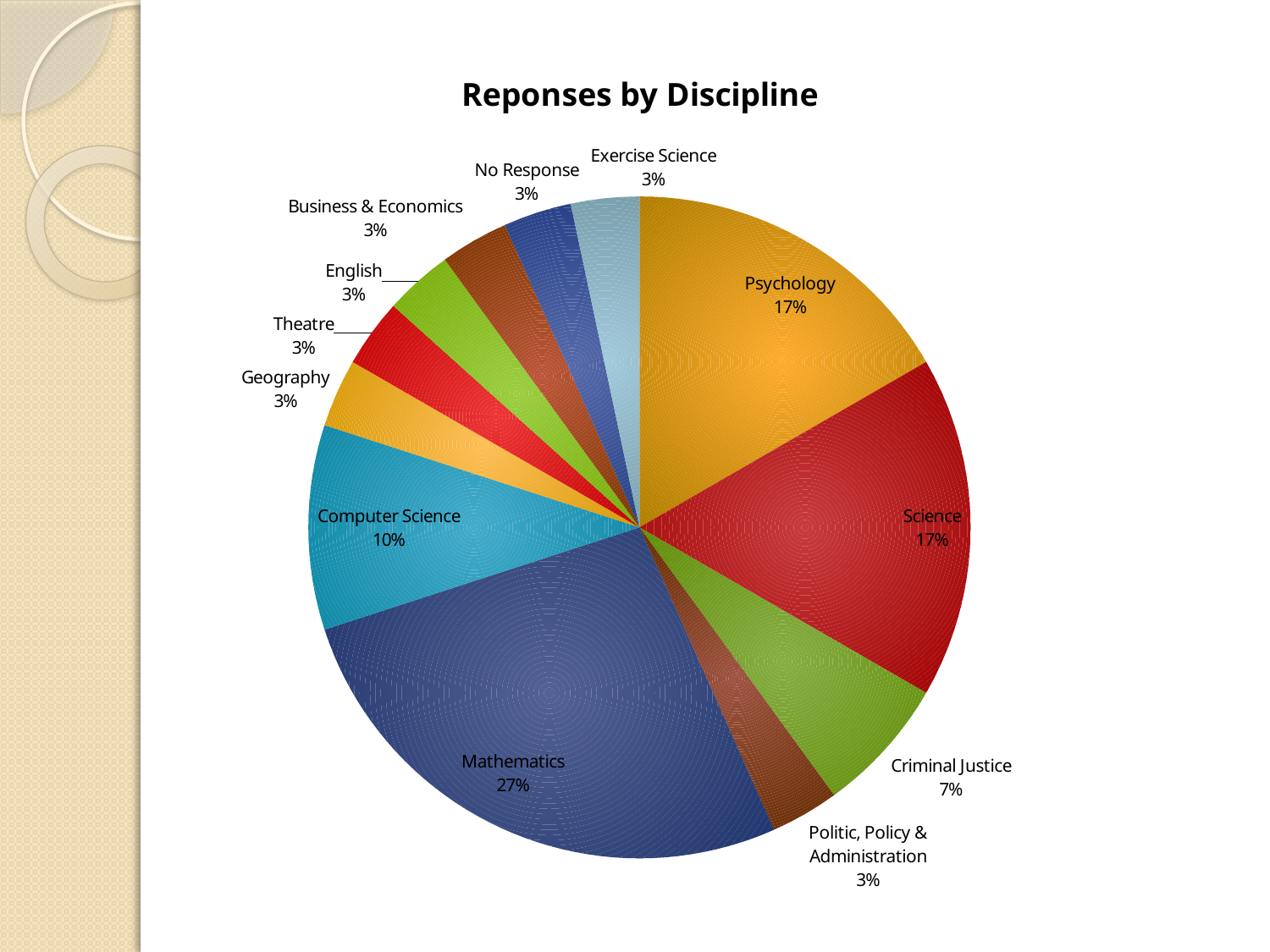
What is the difference in percentage points between Mathematics and Science? 10 Which has a larger share, Computer Science or Criminal Justice? Computer Science What share of responses comes from Mathematics? 27% What is the title of the chart? Reponses by Discipline What type of chart is shown on the slide? pie chart What is the combined share of Psychology and Science? 34% What share of responses comes from Computer Science? 10% What share of responses comes from Criminal Justice? 7% How many slices does the pie chart have? 12 Which discipline has the largest share of responses? Mathematics What percentage is shown for Psychology? 17% What percentage is shown for Politic, Policy & Administration? 3%